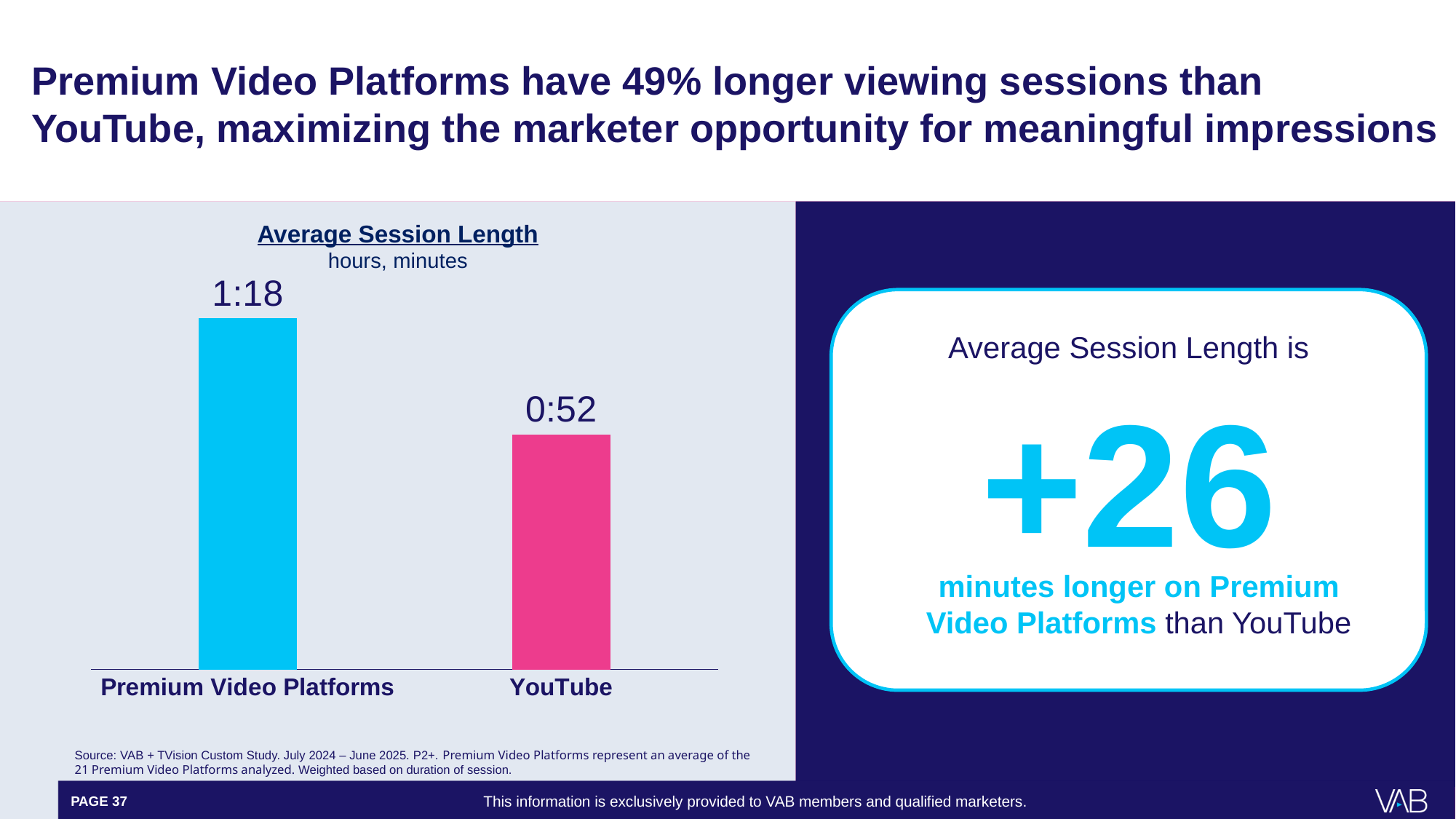
What is the average session length for Premium Video Platforms? 1:18 What is the title of the chart? Average Session Length How many categories are shown in the chart? 2 What is the average session length for YouTube? 0:52 How many minutes longer is the average session length on Premium Video Platforms than on YouTube? 26 minutes In what units is the chart's data expressed? hours, minutes Which category has the longer average session length? Premium Video Platforms Which category has the shorter average session length? YouTube Is the average session length for Premium Video Platforms larger or smaller than for YouTube? larger What type of chart is shown on the slide? bar chart